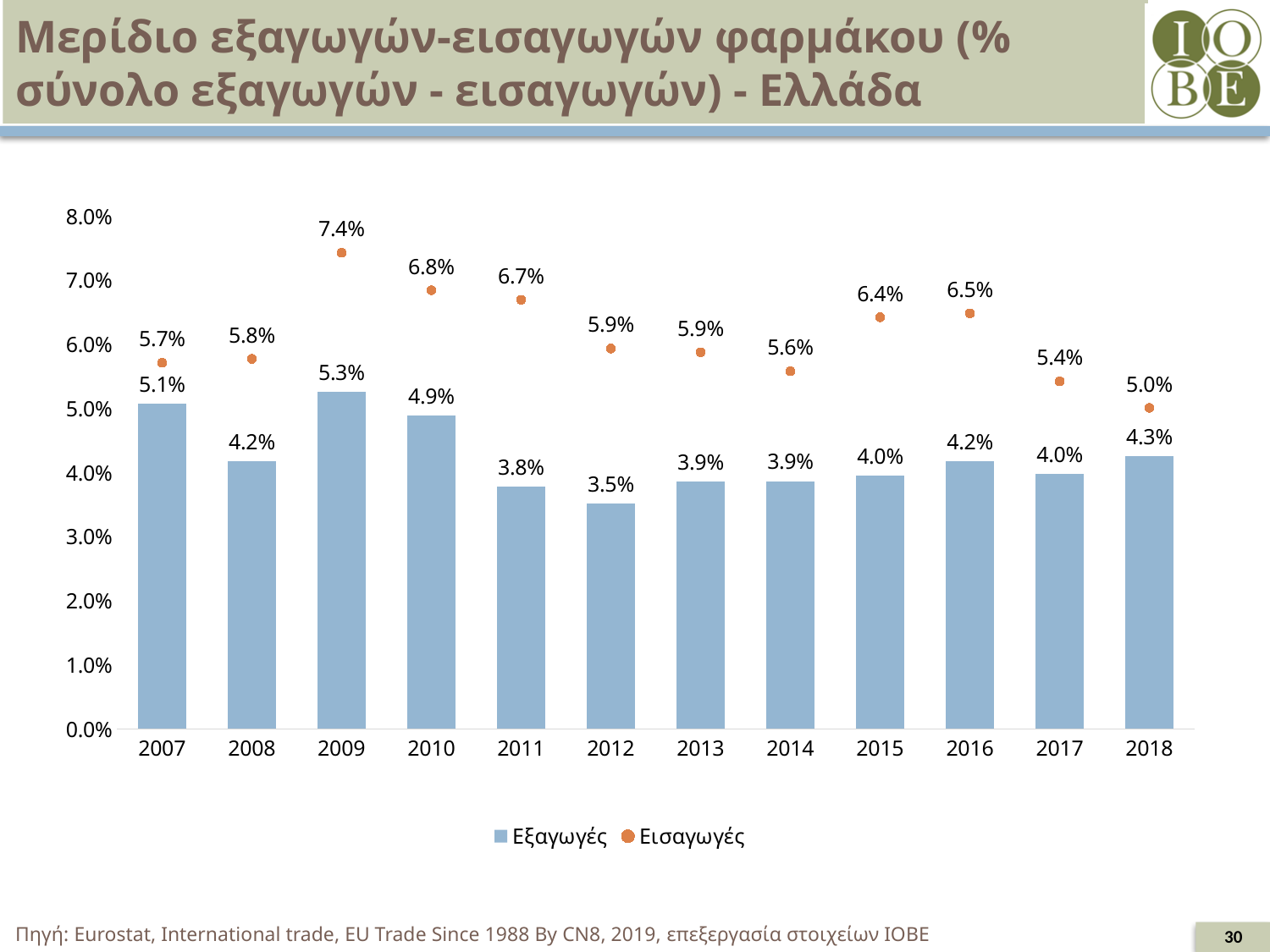
How many series does the legend list? 2 What is the value of Εισαγωγές for 2011? 6.7% How many years are shown on the x axis? 12 What is the value of Εξαγωγές for 2009? 5.3% Does Εξαγωγές rise or fall from 2009 to 2012? Fall What is the difference between Εισαγωγές and Εξαγωγές in 2010? 1.9% In which year is Εξαγωγές lowest? 2012 Is the value of Εισαγωγές for 2009 greater or less than 7.0%? greater Which is larger in 2016, Εξαγωγές or Εισαγωγές? Εισαγωγές In which year is Εισαγωγές highest? 2009 What kind of chart is used to show Εξαγωγές? Bar chart What is the value of Εισαγωγές for 2018? 5.0%